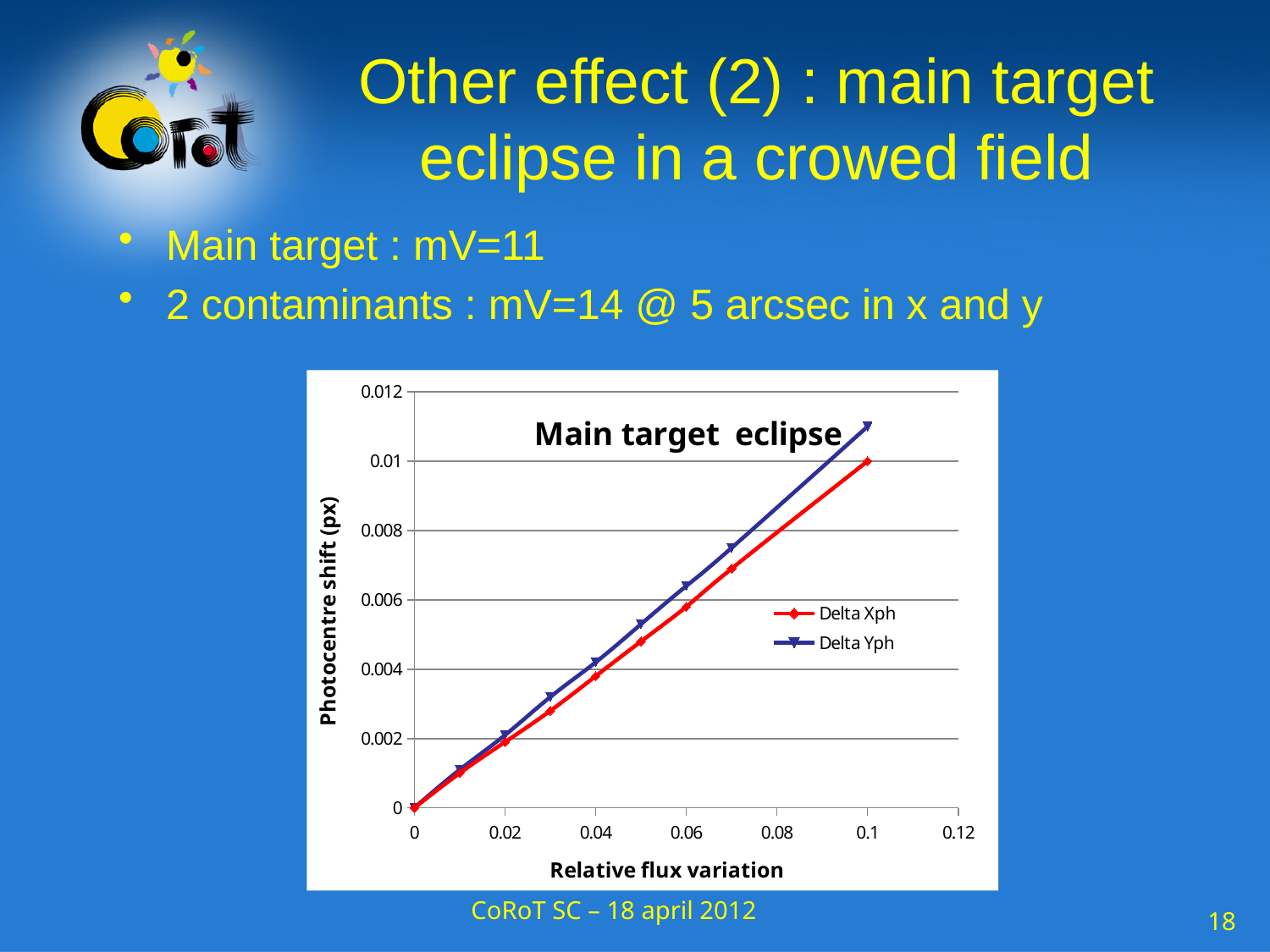
How many data points are plotted for the Delta Xph series? 9 What is the title of the chart? Main target eclipse Do the Delta Yph values rise or fall as the relative flux variation increases? rise What is the label of the y axis of the chart? Photocentre shift (px) How many series does the chart legend list? 2 Is the Delta Xph value at a relative flux variation of 0.07 greater or less than 0.008? less At a relative flux variation of 0.1, which series has the larger photocentre shift, Delta Xph or Delta Yph? Delta Yph Is the Delta Yph value at a relative flux variation of 0.1 greater or less than 0.01? greater Is the Delta Xph value at a relative flux variation of 0.05 greater or less than 0.006? less What kind of chart is shown on the slide? line chart What is the Delta Xph value at a relative flux variation of 0.1? 0.01